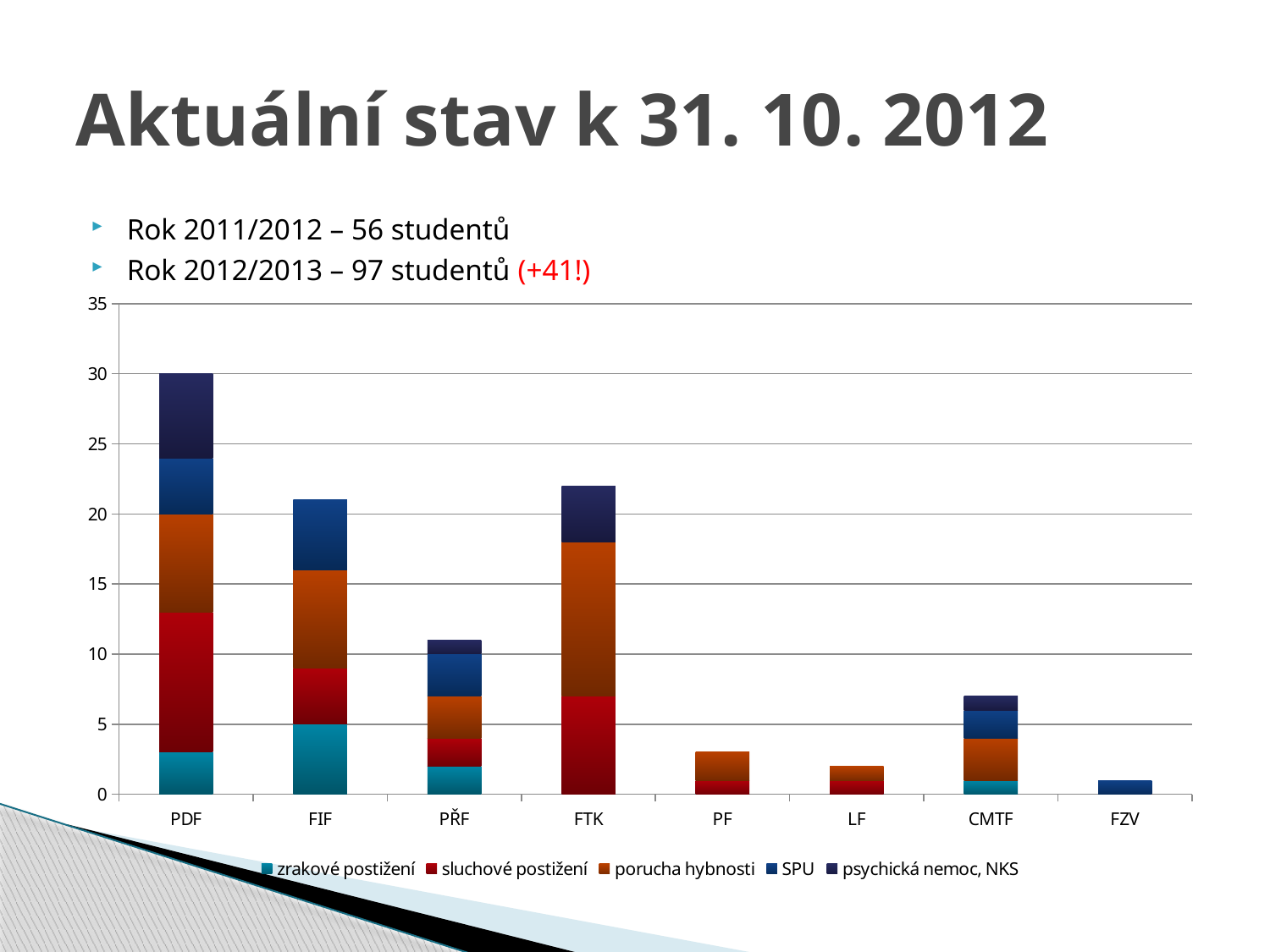
Which faculty has the tallest stacked bar in the chart? PDF What is the total height of the stacked bar for PDF? 30 Which faculty has the shortest stacked bar in the chart? FZV Is the total value for FTK greater or less than 20? greater How many series does the chart's legend list? 5 Which stacked bar is taller, PDF or FTK? PDF Is the total value for PF greater or less than 5? less Is the total value for CMTF greater or less than 5? greater What kind of chart is shown on the slide? stacked bar chart How many faculties (categories) are shown on the x axis of the chart? 8 Which series is listed first in the chart's legend? zrakové postižení